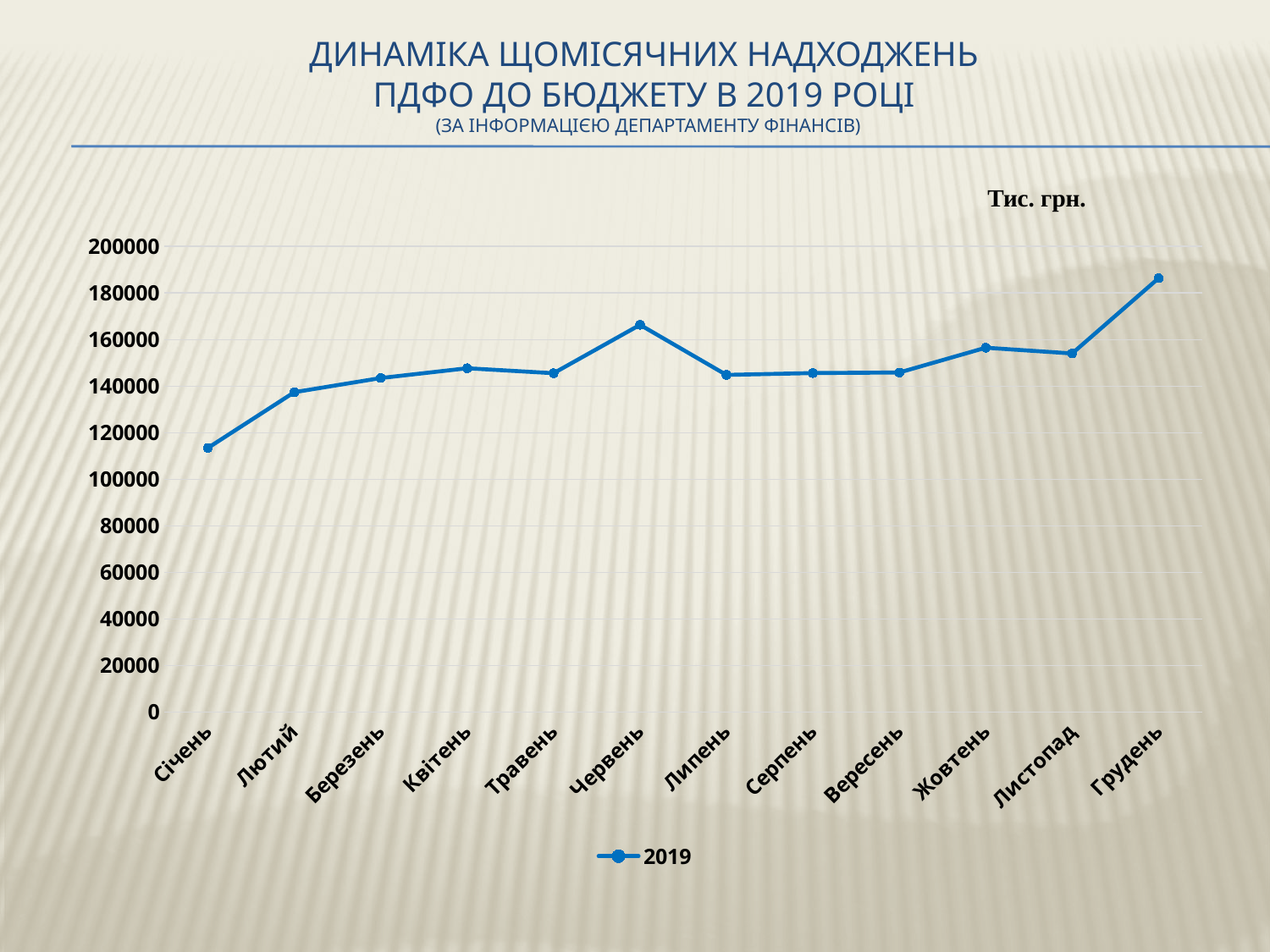
Is the value for Січень greater or less than 120000? less Is the value for Грудень greater or less than 180000? greater Overall, do the values rise or fall from Січень to Грудень? rise Which month has the highest value? Грудень Is the value for Червень greater or less than 160000? greater How many series does the legend list? 1 Which is larger, the value for Червень or the value for Липень? Червень What series name is shown in the legend? 2019 How many months are plotted along the x axis? 12 Which month has the lowest value? Січень What kind of chart is shown on the slide? line chart